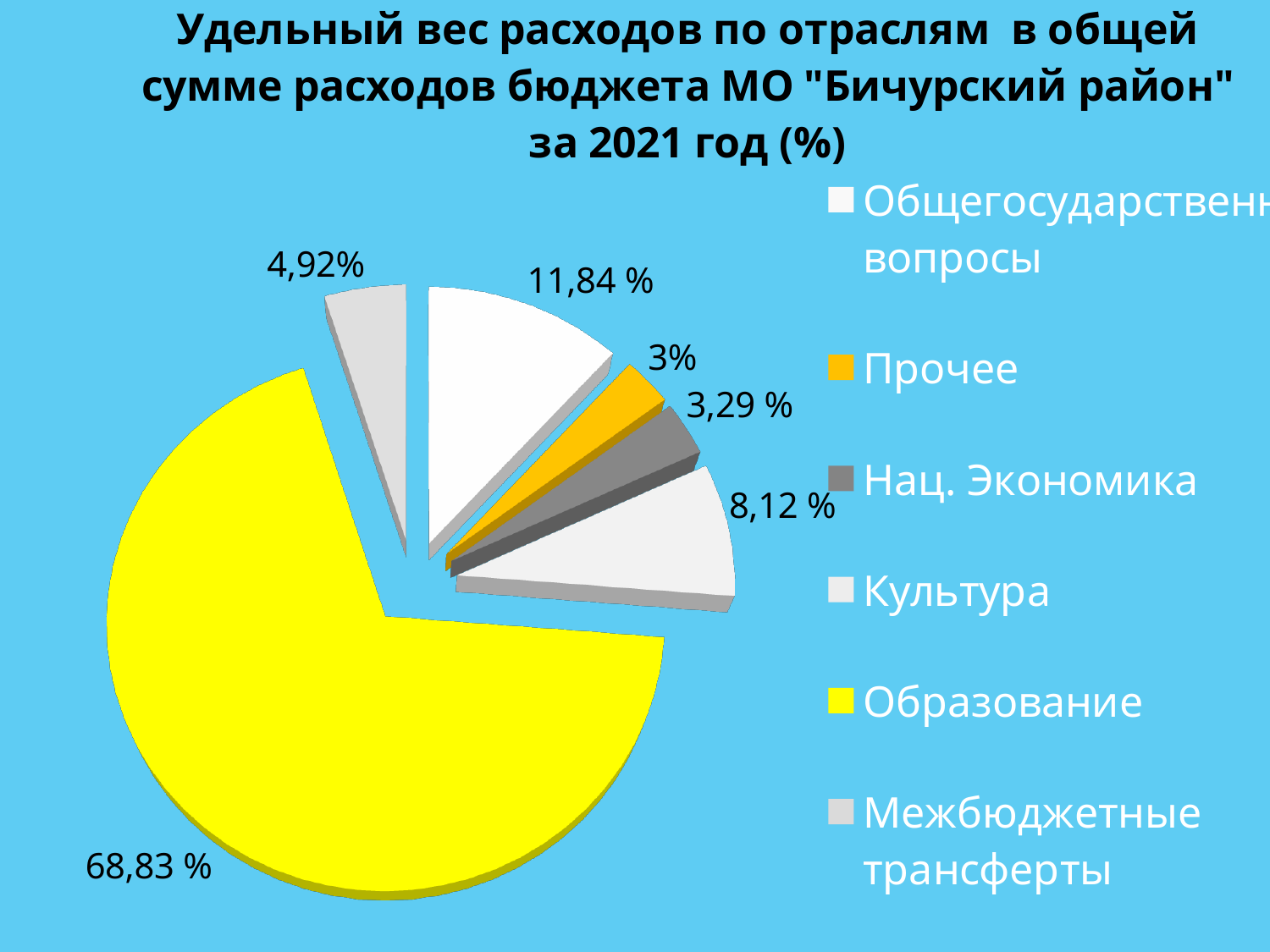
What is the value shown for Прочее? 3% Which category has the largest share of the pie? Образование How many slices does the pie chart have? 6 What is the value shown for Нац. Экономика? 3,29 % How many entries does the legend list? 6 What kind of chart is shown on the slide? pie chart What share of expenditures does Образование account for? 68,83 % Which category has the smallest share of the pie? Прочее What is the value shown for Межбюджетные трансферты? 4,92% What is the value shown for Культура? 8,12 % What colour is the slice for Образование? yellow Which is larger, the share for Культура or the share for Межбюджетные трансферты? Культура